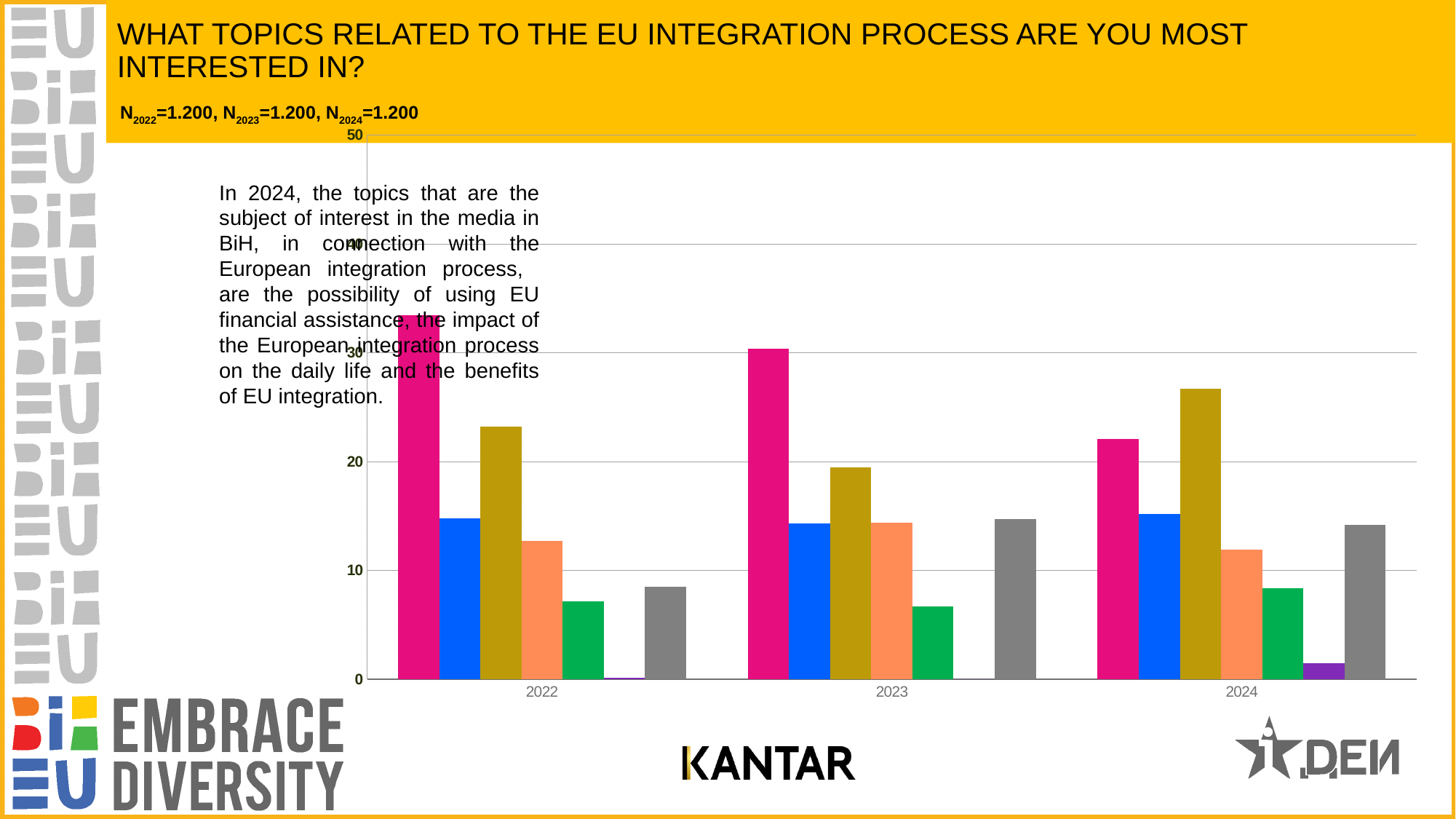
What kind of chart is shown on the slide? bar chart Which year's group contains the tallest bar in the chart? 2022 Which is larger, the pink bar for 2022 or the pink bar for 2024? 2022 Which coloured bar is the highest in the 2024 group? gold Which coloured bar is the lowest in the 2024 group? purple Is the value of the pink bar for 2024 greater or less than 30? less Is the value of the pink bar for 2022 greater or less than 30? greater Which coloured bar is the highest in the 2022 group? pink Is the value of the gold bar for 2024 greater or less than 20? greater Do the pink bars rise or fall from 2022 to 2024? fall How many year categories are shown on the x axis of the chart? 3